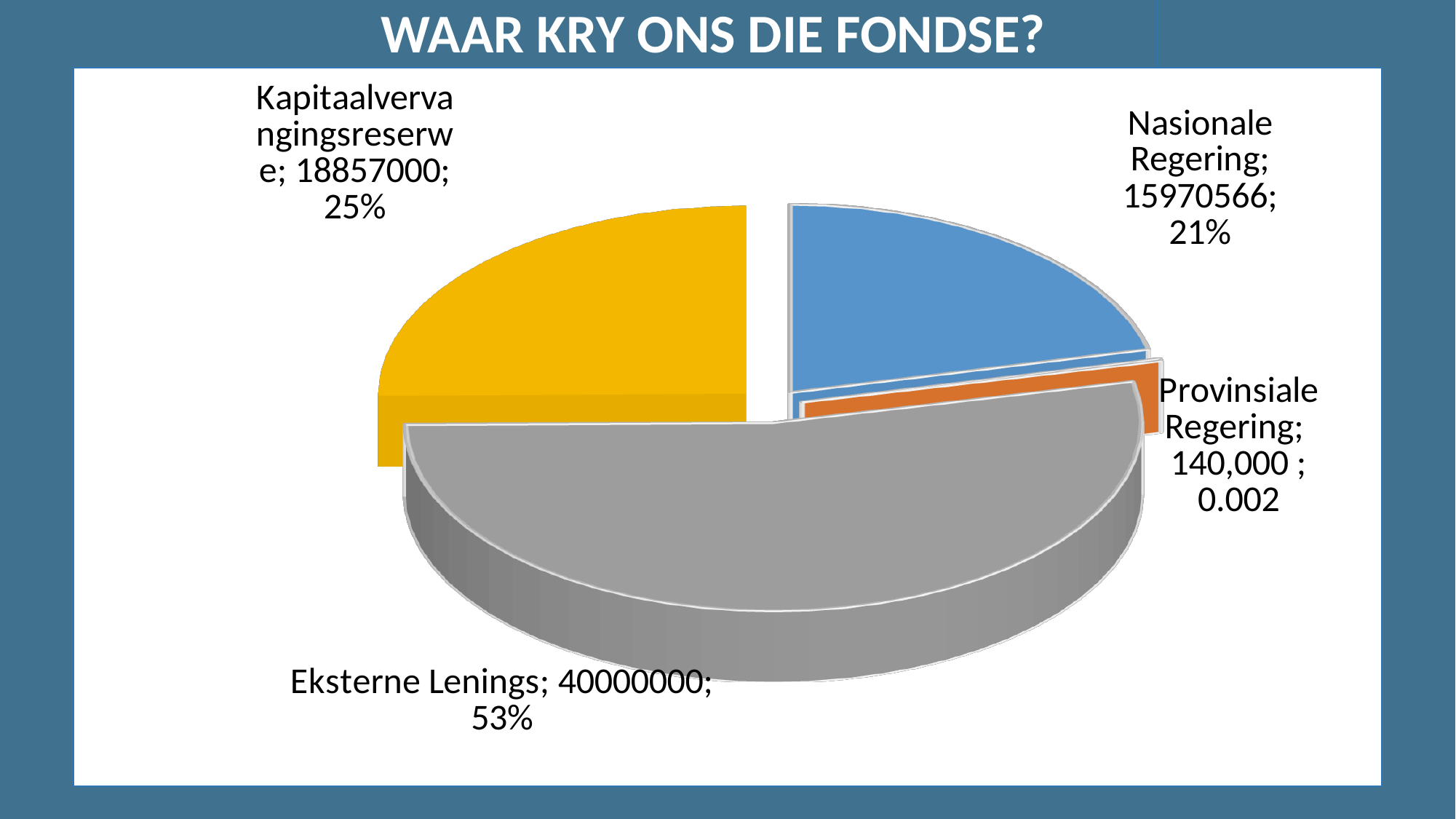
What is the value shown for Kapitaalvervangingsreserwe? 18857000 What is the value shown for Nasionale Regering? 15970566 What percentage share of the pie does Nasionale Regering have? 21% What is the title of the chart on the slide? WAAR KRY ONS DIE FONDSE? What is the value shown for Eksterne Lenings? 40000000 Which category has the largest slice of the pie? Eksterne Lenings What kind of chart is shown on the slide? pie chart What percentage share of the pie does Eksterne Lenings have? 53% What is the difference between the values for Eksterne Lenings and Kapitaalvervangingsreserwe? 21143000 What is the value shown for Provinsiale Regering? 140,000 How many slices does the pie chart have? 4 Which category has the smallest slice of the pie? Provinsiale Regering